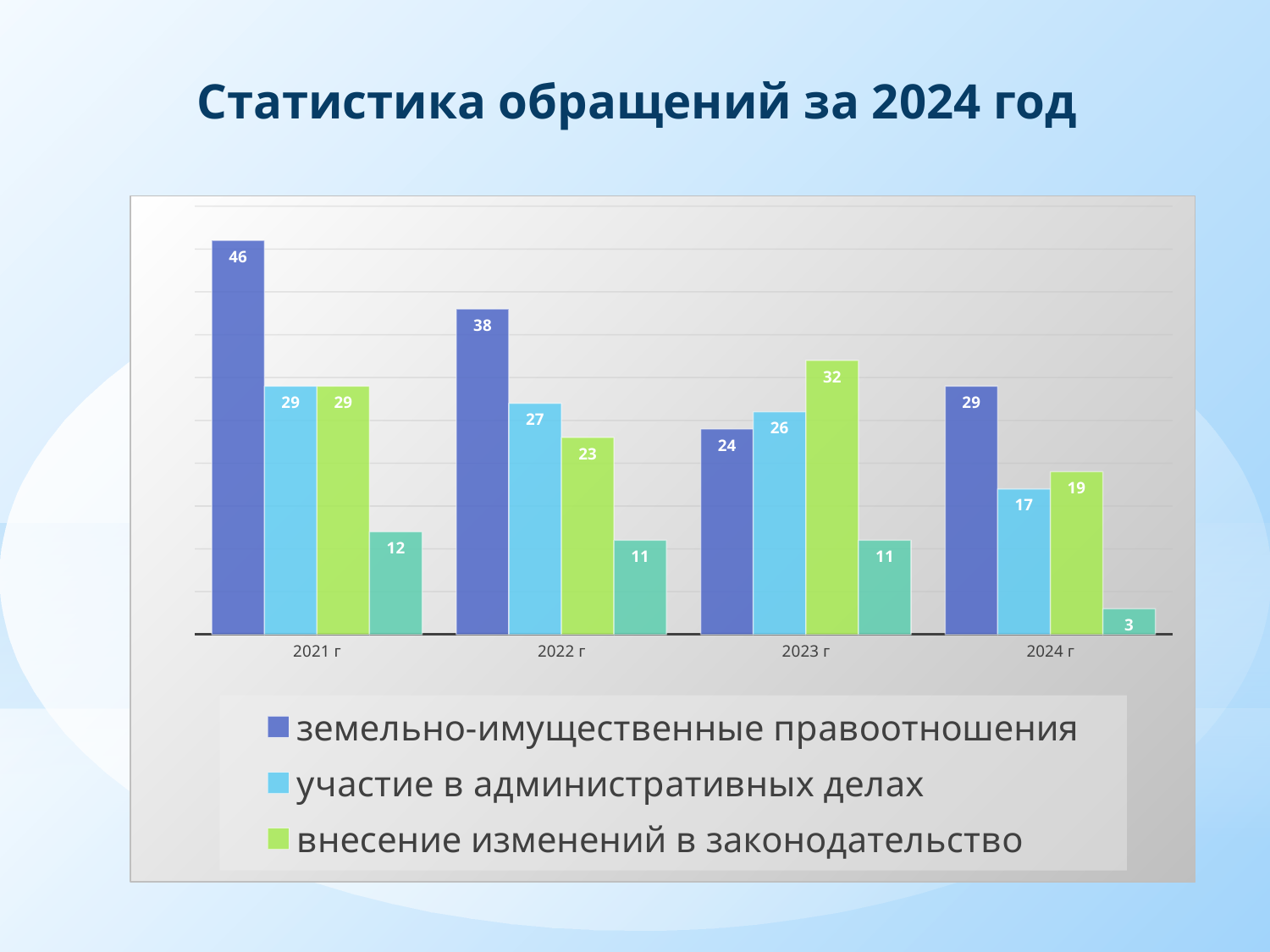
What is the difference between the values for земельно-имущественные правоотношения in 2021 г and 2022 г? 8 Which is larger in 2023 г: земельно-имущественные правоотношения or внесение изменений в законодательство? внесение изменений в законодательство How many series does the legend list? 3 What is the title of the slide? Статистика обращений за 2024 год What is the value for участие в административных делах in 2022 г? 27 What is the value for земельно-имущественные правоотношения in 2021 г? 46 What type of chart is shown on the slide? bar chart In which year is the value for земельно-имущественные правоотношения the highest? 2021 г What is the value for участие в административных делах in 2024 г? 17 How many years are shown on the x axis? 4 What is the value for внесение изменений в законодательство in 2023 г? 32 In which year is the value for внесение изменений в законодательство the lowest? 2024 г